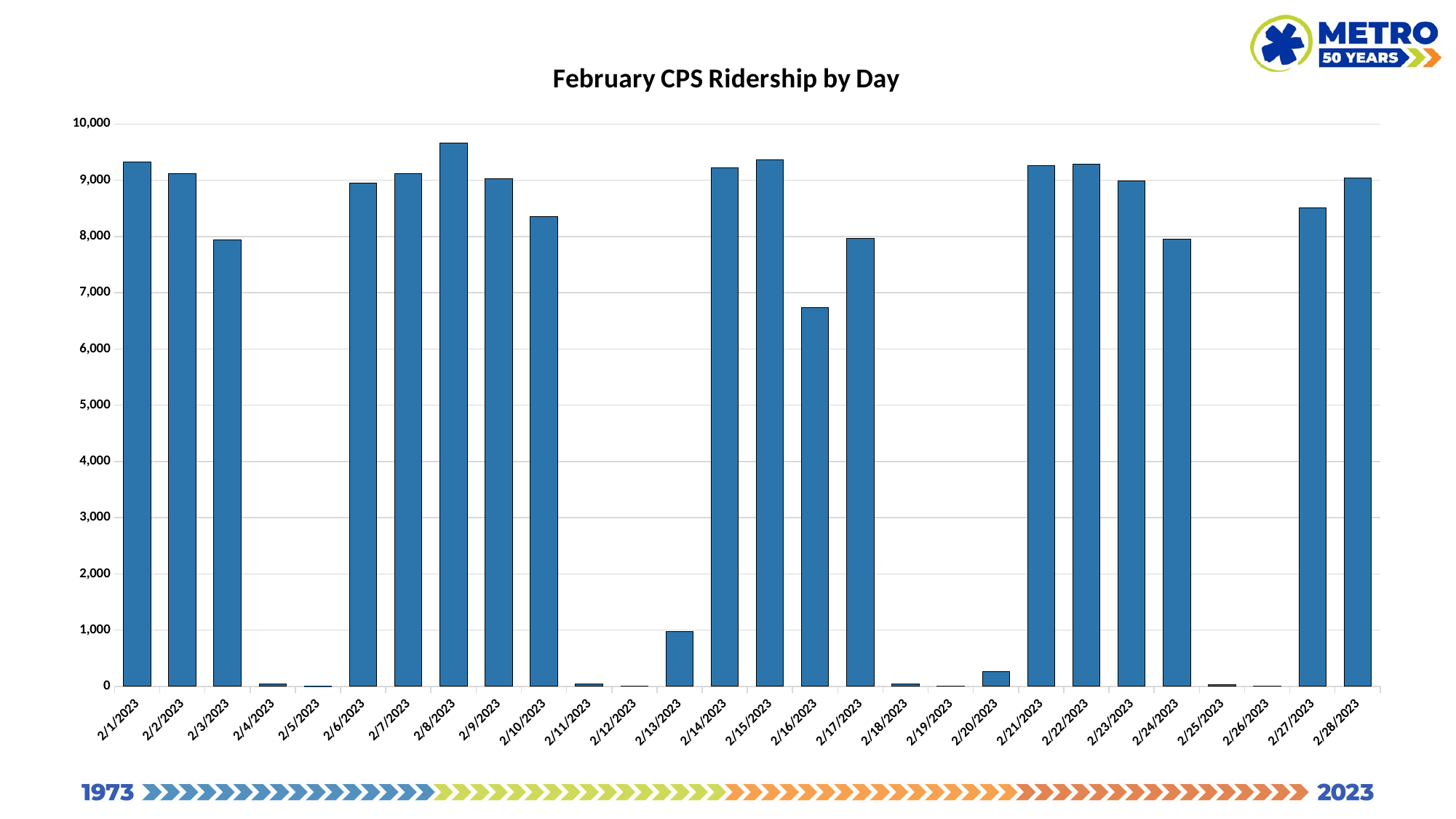
What kind of chart is shown on the slide? bar chart Is the value for 2/10/2023 greater or less than 8,000? greater How many days (bars) are plotted on the x axis? 28 Which day has higher ridership, 2/16/2023 or 2/17/2023? 2/17/2023 Which day has higher ridership, 2/13/2023 or 2/20/2023? 2/13/2023 Is the value for 2/27/2023 greater or less than 8,000? greater Is the value for 2/20/2023 greater or less than 1,000? less What is the title of the chart? February CPS Ridership by Day Which day has the highest ridership? 2/8/2023 Which day has higher ridership, 2/8/2023 or 2/16/2023? 2/8/2023